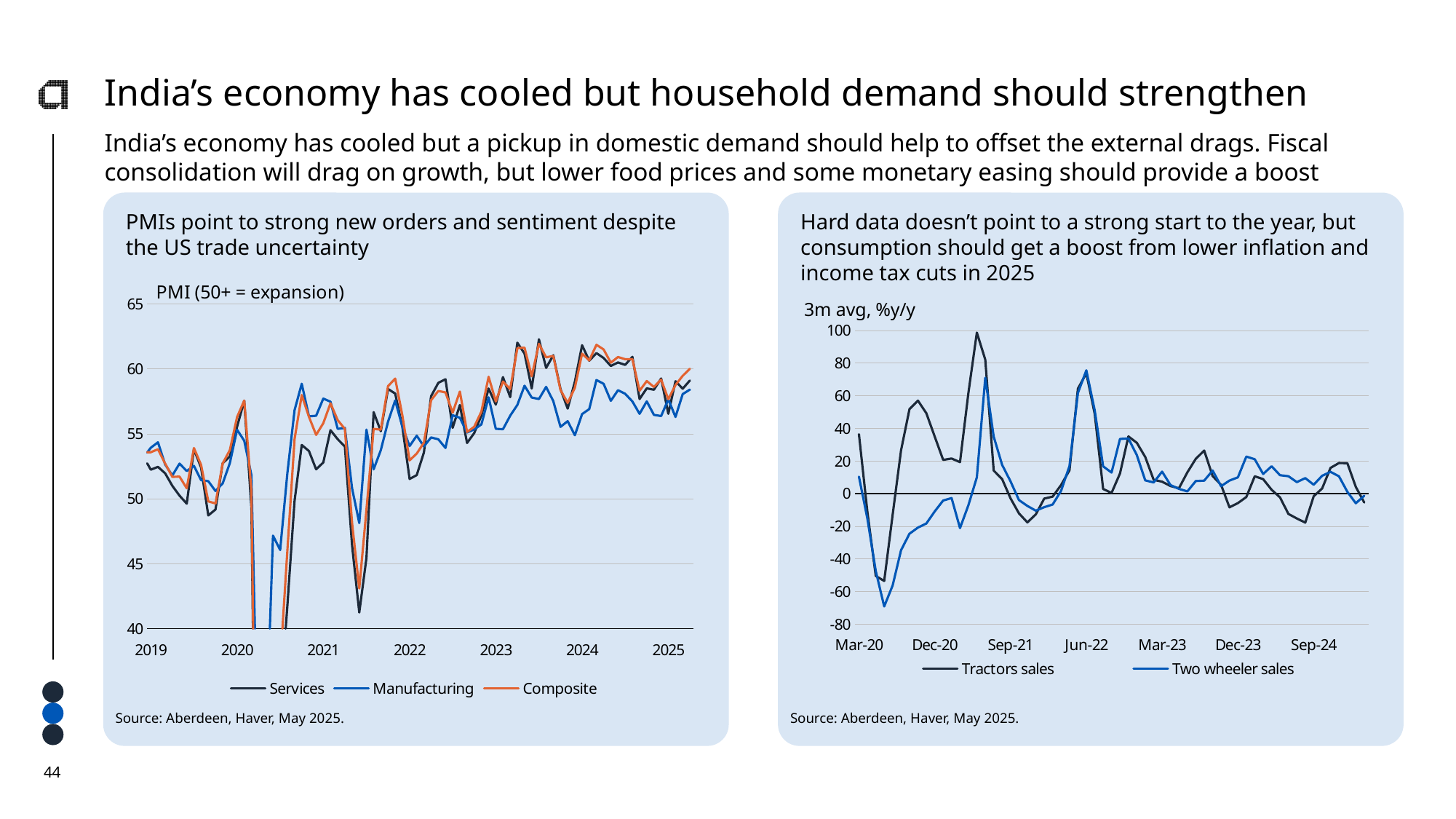
In the left PMI chart, is the lowest Services value during 2021 greater or less than 45? less In the right chart, is the lowest value of Two wheeler sales in 2020 greater or less than -40? less In the left PMI chart, is the lowest Composite value during 2021 greater or less than 50? less What kind of chart is the right chart titled 'Hard data doesn't point to a strong start to the year...'? Line chart What kind of chart is the left chart titled 'PMIs point to strong new orders and sentiment despite the US trade uncertainty'? Line chart What is the y-axis label of the right chart showing tractor and two wheeler sales? 3m avg, %y/y In the left PMI chart, does the Services series overall rise or fall between 2019 and 2025? Rise What is the y-axis label of the left PMI chart? PMI (50+ = expansion) How many series does the legend of the left PMI chart list? 3 How many series does the legend of the right chart (tractor and two wheeler sales) list? 2